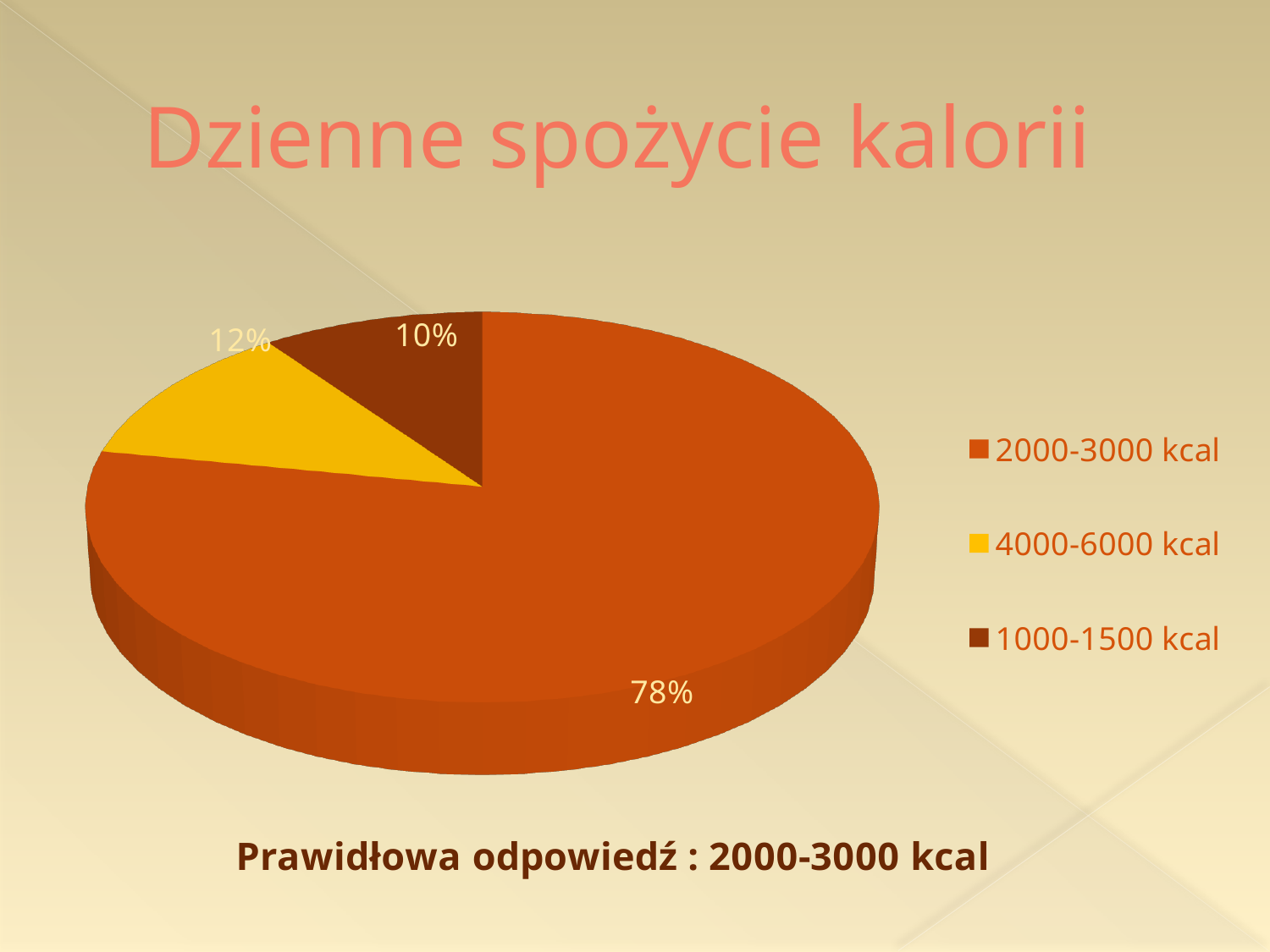
What is the title of the slide containing the chart? Dzienne spożycie kalorii What kind of chart is shown on the slide? Pie chart What share of the pie does the 1000-1500 kcal slice represent? 10% How many categories does the pie chart show? 3 What share of the pie does the 4000-6000 kcal slice represent? 12% Which category is shown in yellow in the legend? 4000-6000 kcal Which category has the largest slice of the pie? 2000-3000 kcal What is the difference in percentage points between the 2000-3000 kcal slice and the 4000-6000 kcal slice? 66 What is the difference in percentage points between the 4000-6000 kcal slice and the 1000-1500 kcal slice? 2 Which category has the smallest slice of the pie? 1000-1500 kcal What share of the pie does the 2000-3000 kcal slice represent? 78% Which slice is larger, 4000-6000 kcal or 1000-1500 kcal? 4000-6000 kcal